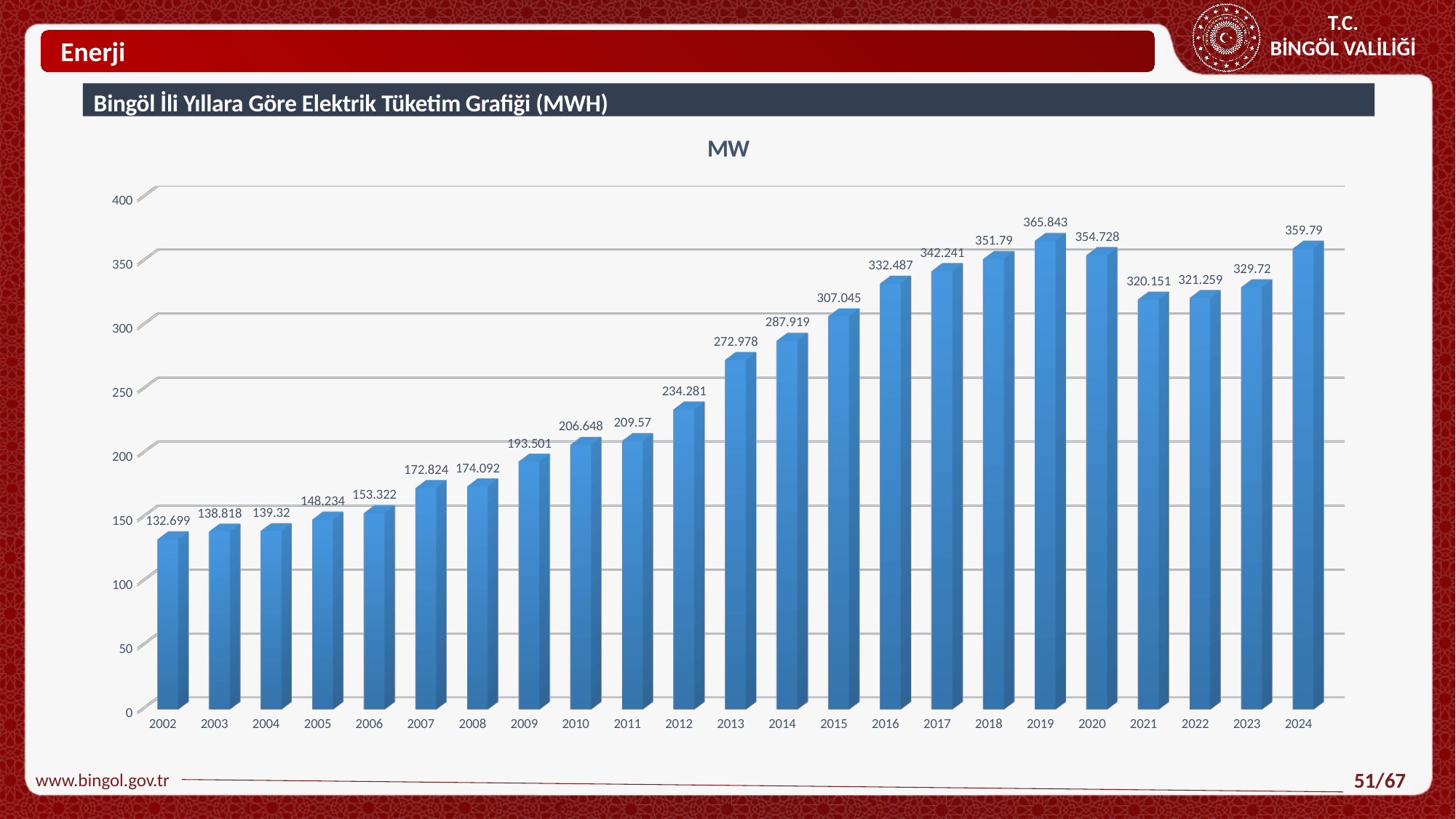
What is the value for 2019? 365.843 Which year has the highest value? 2019 What is the value for 2024? 359.79 What is the difference between the values for 2024 and 2023? 30.07 Which is larger, the value for 2020 or the value for 2021? 2020 What is the value for 2002? 132.699 What kind of chart is this? bar chart What is the title shown above the chart? MW Which year has the lowest value? 2002 Is the value for 2016 greater or less than 300? greater How many years are shown on the x axis? 23 What is the value for 2013? 272.978